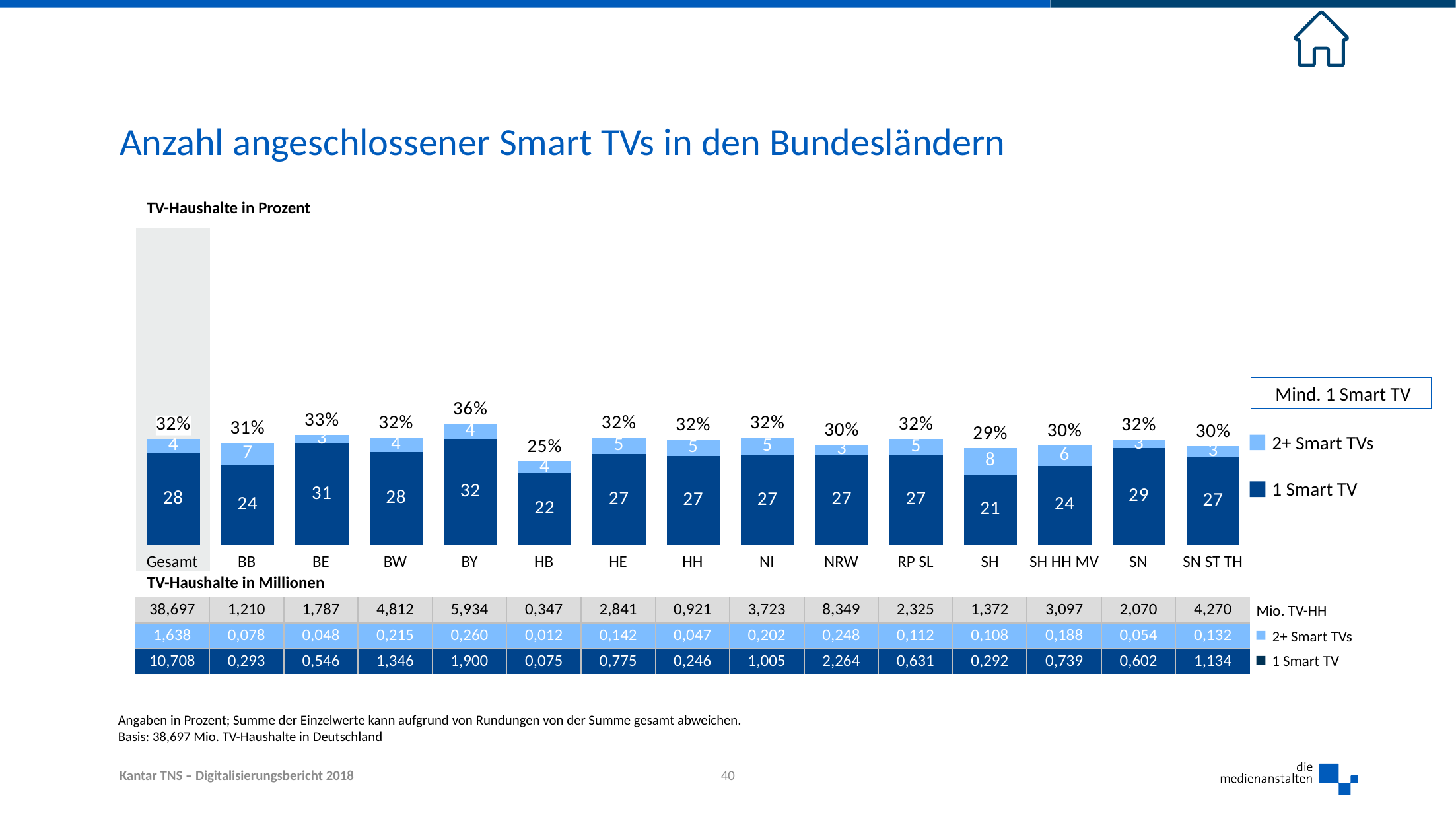
Which Bundesland has the highest Mind. 1 Smart TV percentage? BY What is the difference between the 1 Smart TV values for BY and HB? 10 What is the title of the slide? Anzahl angeschlossener Smart TVs in den Bundesländern How many categories are shown on the x axis of the chart? 15 What kind of chart is shown on the slide? Stacked bar chart How many series does the legend list? 2 Which Bundesland has the lowest Mind. 1 Smart TV percentage? HB What is the total of the stacked bar for Gesamt? 32% What is the value of the 1 Smart TV series for BY? 32 What is the value of the 2+ Smart TVs series for SH? 8 What percentage is shown above the bar for SN (Mind. 1 Smart TV)? 32% Which has a larger 1 Smart TV value, BE or BB? BE